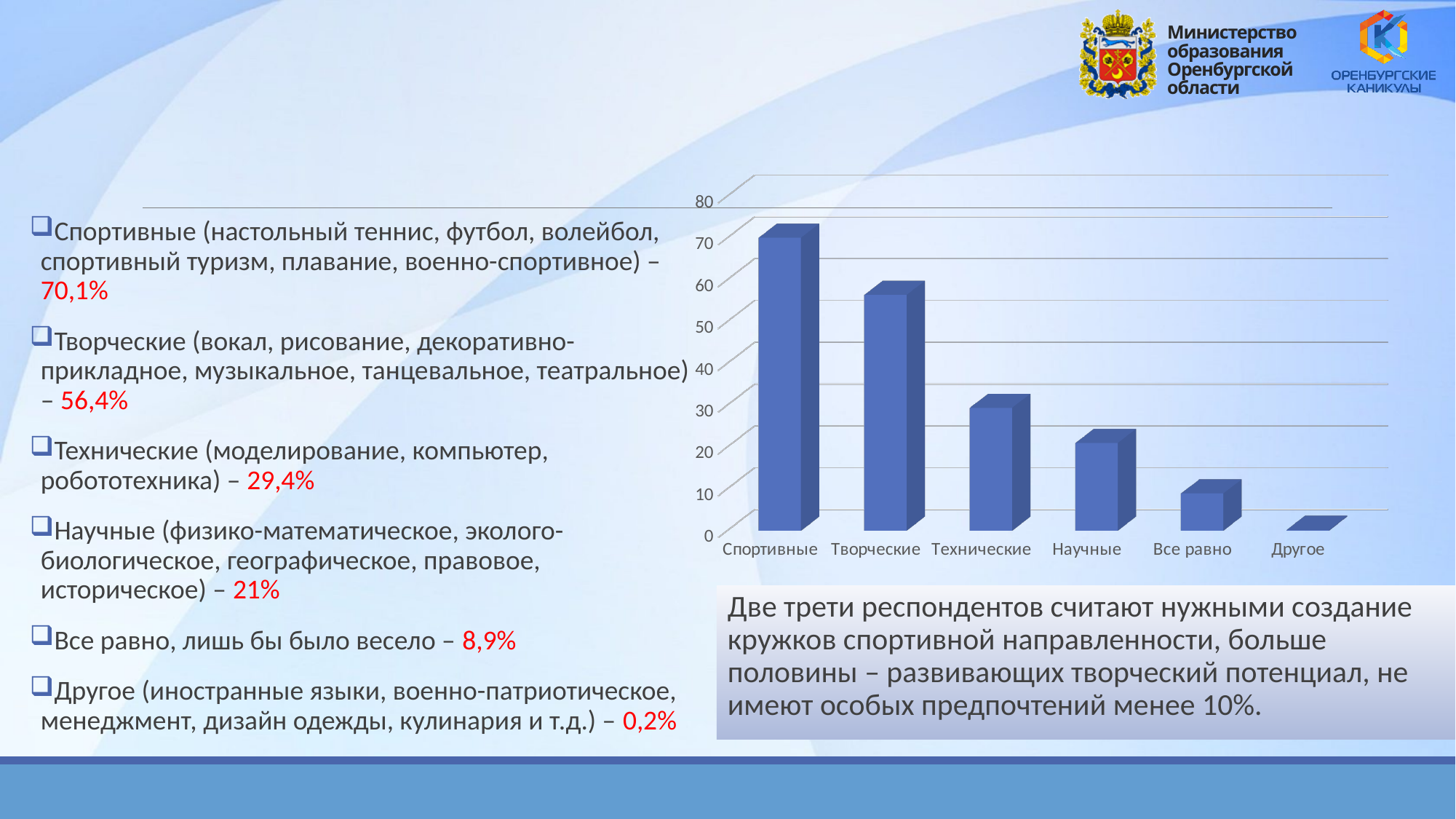
Which category has the highest bar in the chart? Спортивные According to the slide text, what percentage corresponds to the Спортивные category? 70,1% Is the value for Научные greater or less than 30? less Is the value for Технические greater or less than 40? less How many categories are shown on the x axis of the chart? 6 Is the value for Все равно greater or less than 10? less Do the bar values rise or fall from left to right along the x axis? fall Which category has the lowest bar in the chart? Другое What kind of chart is shown on the slide? bar chart Which is larger, the bar for Технические or the bar for Научные? Технические